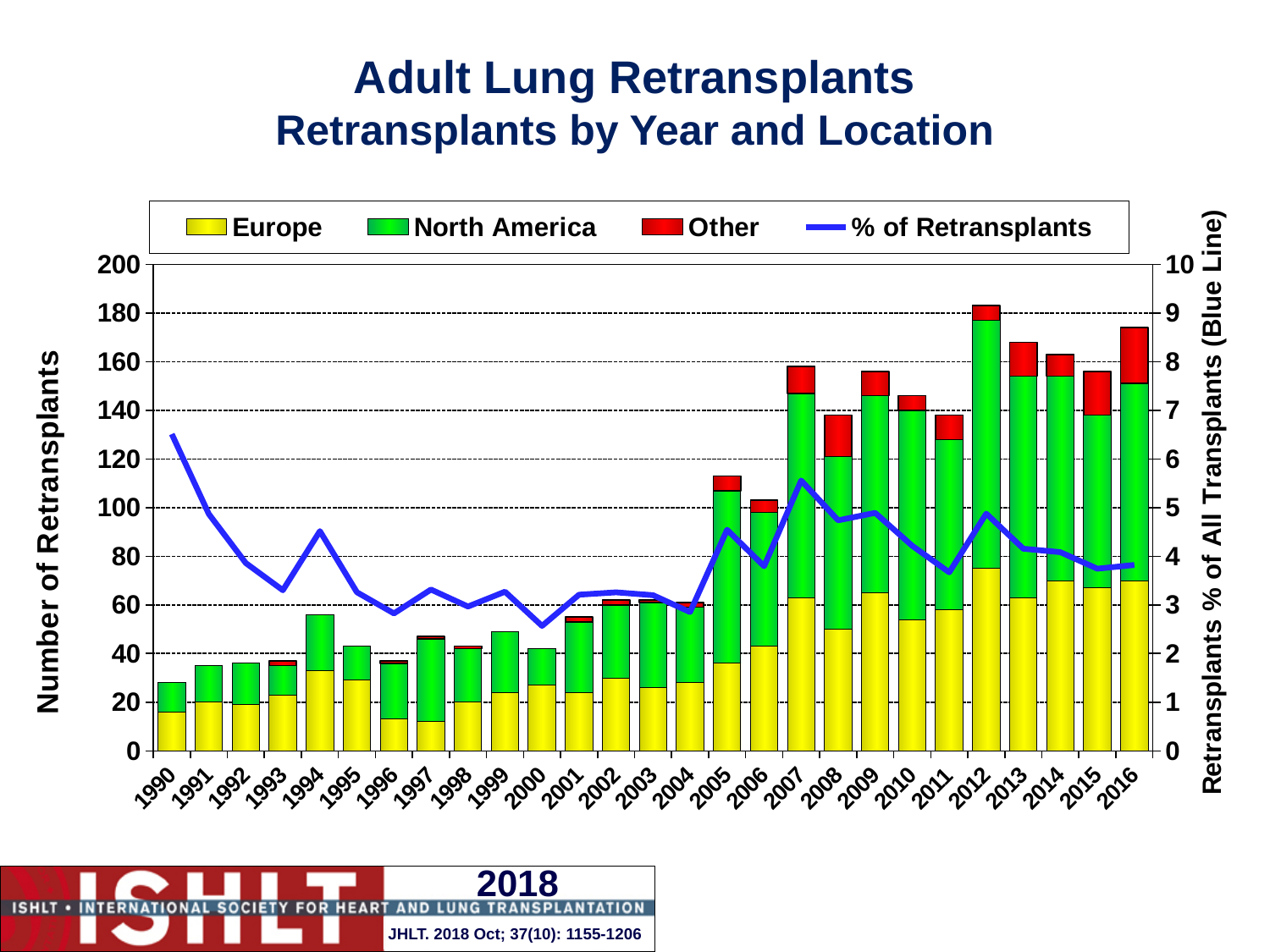
Which year has the highest total number of retransplants? 2012 Which year has the larger total number of retransplants, 2007 or 2008? 2007 What colour represents Europe in the chart? Yellow In which year is the % of Retransplants line at its highest? 1990 How many years are shown on the x axis of the chart? 27 Is the total number of retransplants in 1990 greater or less than 40? less Do the total numbers of retransplants generally rise or fall from 2000 to 2007? rise What kind of chart is used to show the number of retransplants by year? Stacked bar chart (with a line for % of retransplants) Is the total number of retransplants in 2012 greater or less than 160? greater Is the % of Retransplants value in 1990 greater or less than 6? greater How many entries does the chart legend list? 4 Which year has the lowest total number of retransplants? 1990